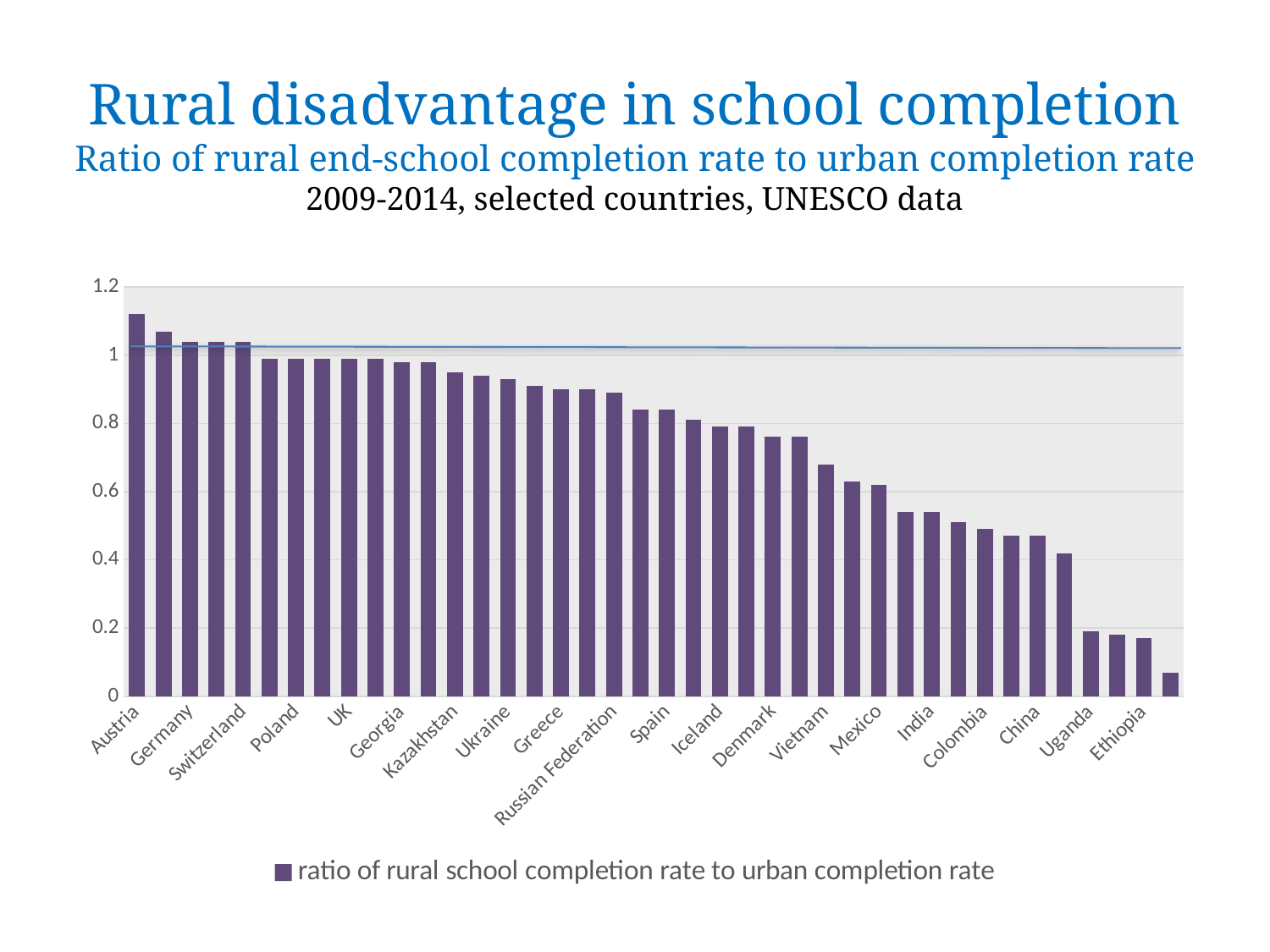
What kind of chart is shown on the slide? bar chart Is the value for Austria greater or less than 1? greater Is the value for China greater or less than 0.6? less Do the values rise or fall moving from left to right along the x axis? fall Which country has the highest ratio of rural to urban school completion rate? Austria Is the value for Vietnam greater or less than 0.8? less What is the legend entry for the plotted series? ratio of rural school completion rate to urban completion rate Which has a higher ratio, Germany or China? Germany How many series does the legend list? 1